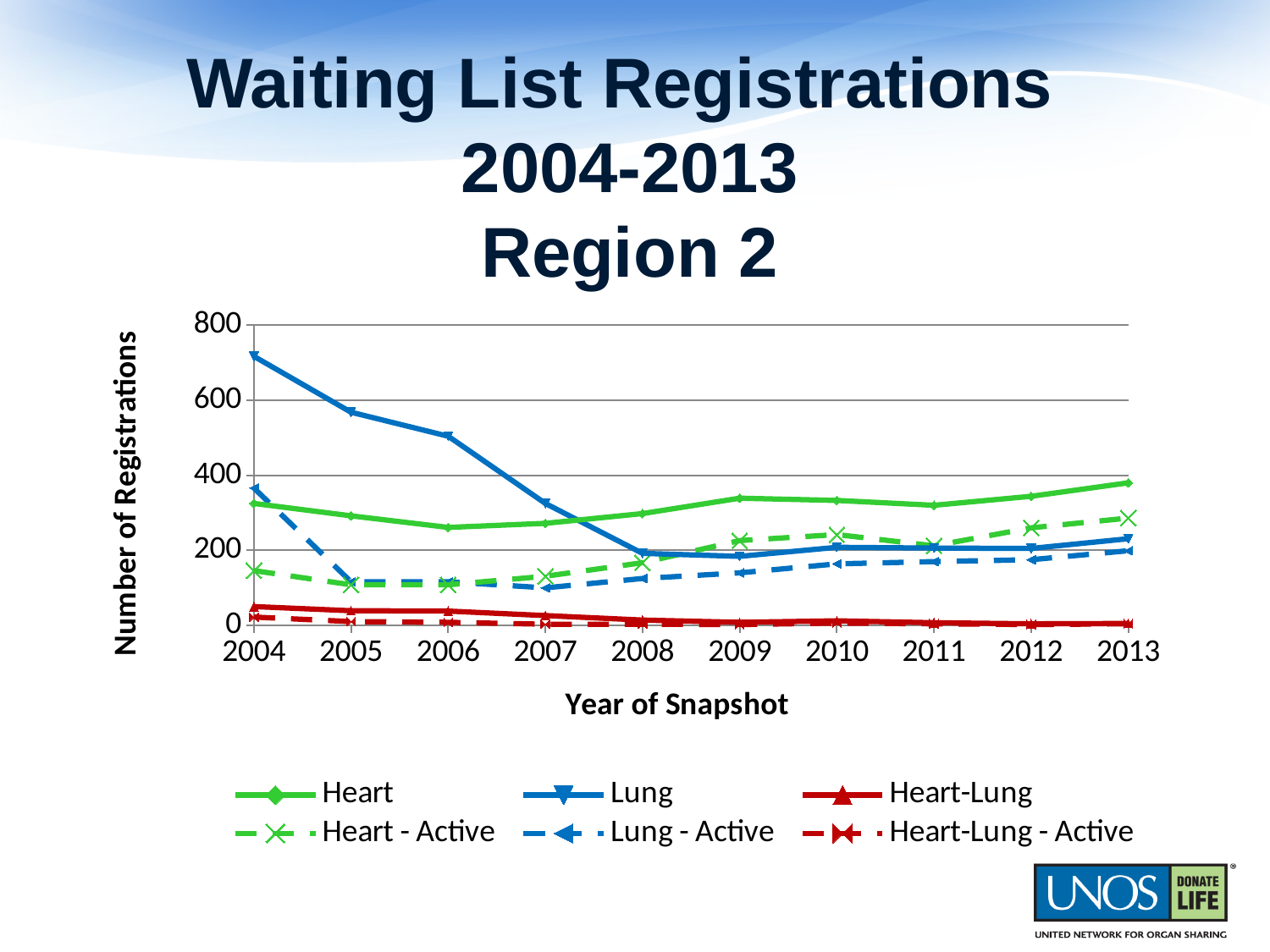
How many series does the legend list? 6 Does the Lung series rise or fall from 2004 to 2008? fall Is the value for Heart in 2013 greater or less than 400? less Is the value for Lung in 2004 greater or less than 600? greater What kind of chart is shown on the slide? line chart Which series has the higher value in 2013, Heart or Lung? Heart Is the value for Lung in 2007 greater or less than 200? greater How many years are shown along the x axis? 10 Which series has the higher value in 2004, Heart or Lung? Lung In which year is the Lung series at its highest? 2004 What is the title of the x axis? Year of Snapshot